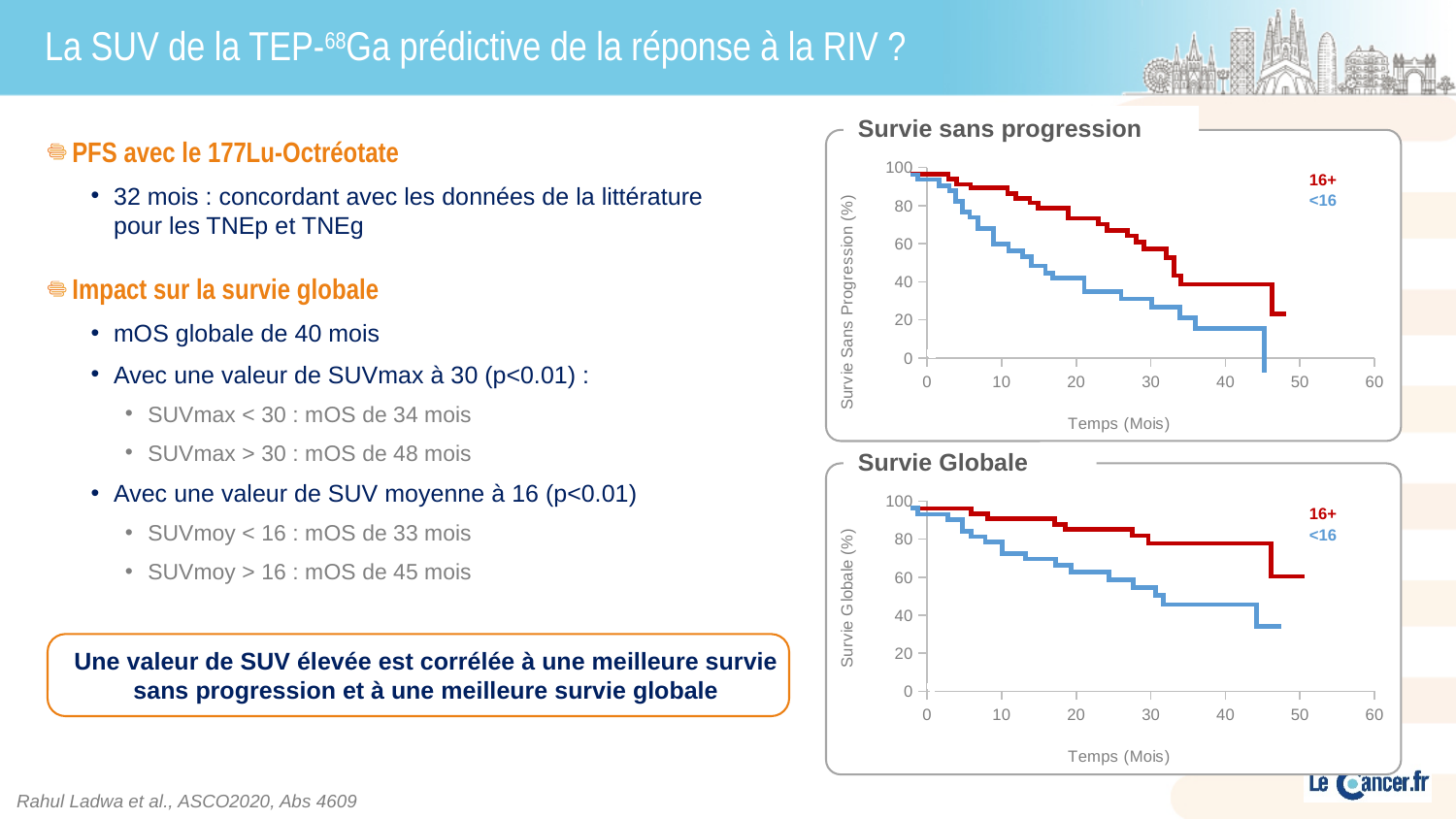
In the 'Survie sans progression' chart, is the value of the 16+ curve at 20 months greater or less than 60? greater What are the two series named in the legend of the 'Survie sans progression' chart? 16+ and <16 In the 'Survie sans progression' chart, is the value of the <16 curve at 20 months greater or less than 60? less In the 'Survie sans progression' chart, which series is higher at 30 months, 16+ or <16? 16+ What kind of chart is the 'Survie sans progression' chart? line chart In the 'Survie Globale' chart, is the value of the 16+ curve at 40 months greater or less than 60? greater How many series does the legend of the 'Survie Globale' chart list? 2 What is the x-axis title of the 'Survie Globale' chart? Temps (Mois) In the 'Survie Globale' chart, which series is higher at 20 months, 16+ or <16? 16+ In the 'Survie sans progression' chart, do the curves rise or fall as time increases along the x axis? fall In the 'Survie Globale' chart, which series ends at the lower survival value, 16+ or <16? <16